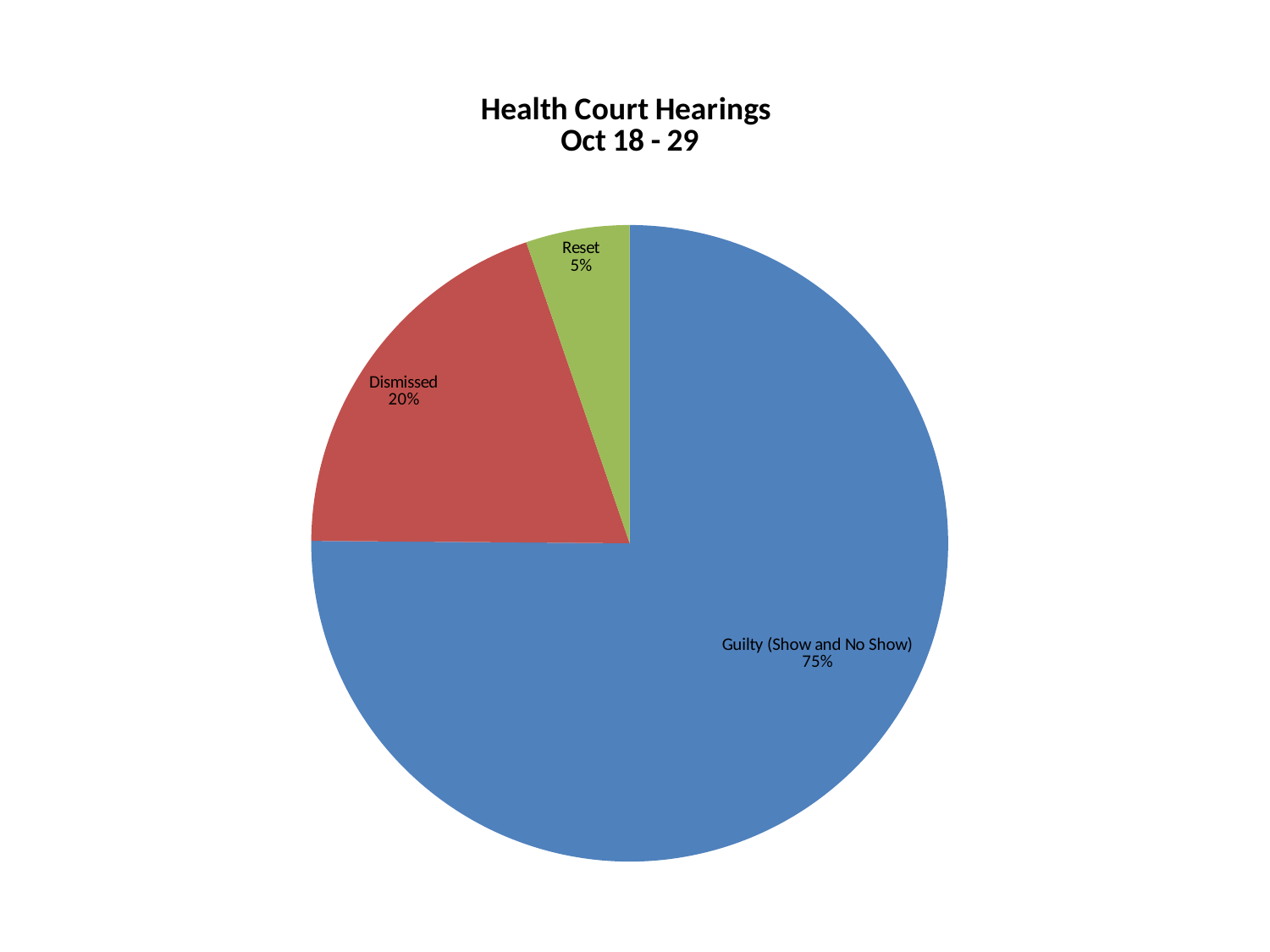
What is the title of the chart? Health Court Hearings Oct 18 - 29 What share of the pie is Guilty (Show and No Show)? 75% What share of the pie is Dismissed? 20% What colour is the Dismissed slice? red Which category has the largest slice? Guilty (Show and No Show) What is the difference in percentage points between Guilty (Show and No Show) and Dismissed? 55% What share of the pie is Reset? 5% Which category has the smallest slice? Reset What is the difference in percentage points between Dismissed and Reset? 15% What kind of chart is shown on the slide? pie chart Which is larger, Dismissed or Reset? Dismissed How many slices does the pie chart have? 3